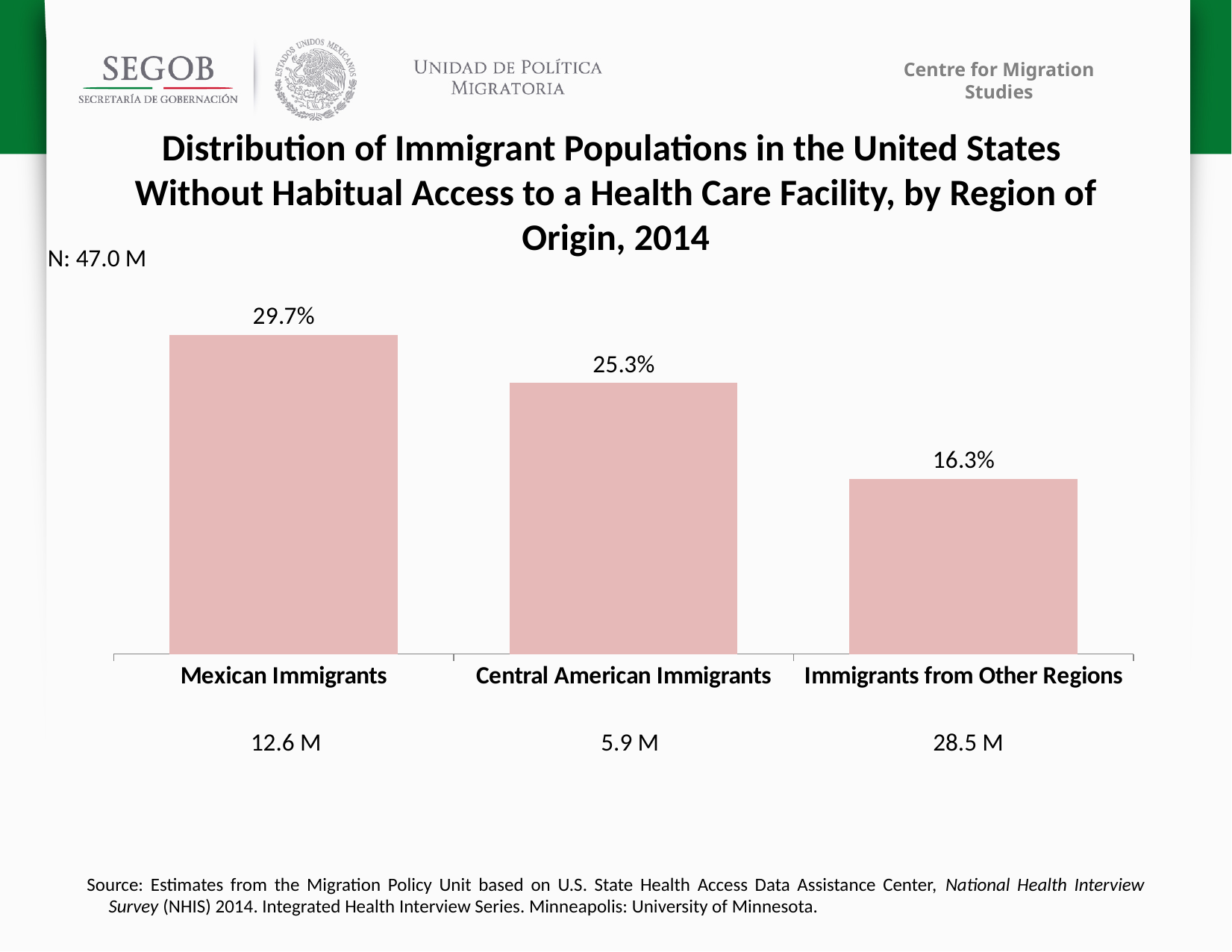
How many categories are shown in the chart? 3 What kind of chart is shown on the slide? Bar chart What population size (in millions) is shown beneath the Immigrants from Other Regions bar? 28.5 M What percentage of Mexican Immigrants are without habitual access to a health care facility? 29.7% What is the difference in percentage points between Mexican Immigrants and Central American Immigrants? 4.4 percentage points What is the difference in percentage points between Central American Immigrants and Immigrants from Other Regions? 9.0 percentage points Which category has the highest percentage? Mexican Immigrants Which is larger, the value for Central American Immigrants or the value for Immigrants from Other Regions? Central American Immigrants Which category has the lowest percentage? Immigrants from Other Regions What is the value shown for Immigrants from Other Regions? 16.3% Do the values rise or fall from left to right across the categories? Fall What is the value shown for Central American Immigrants? 25.3%